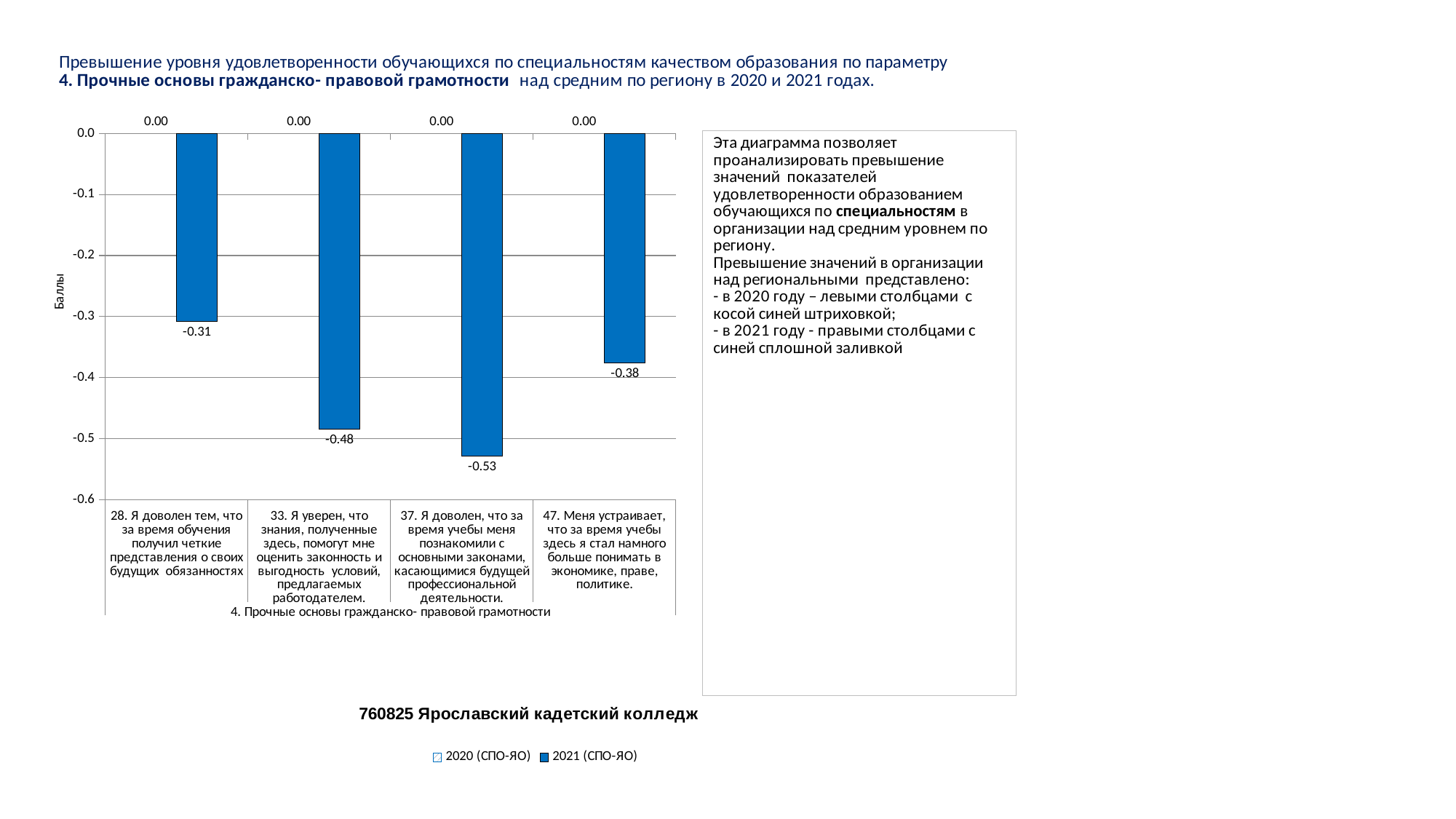
What type of chart is shown on the slide? Bar chart What is the difference between the 2021 (СПО-ЯО) values for category 33 and category 28? 0.17 How many series does the chart legend list? 2 Which category has the highest 2021 (СПО-ЯО) value? 28. Я доволен тем, что за время обучения получил четкие представления о своих будущих обязанностях What is the 2021 (СПО-ЯО) value for category 47 (Меня устраивает, что за время учебы здесь я стал намного больше понимать в экономике, праве, политике)? -0.38 What is the 2020 (СПО-ЯО) value for category 33 (Я уверен, что знания, полученные здесь, помогут мне оценить законность и выгодность условий)? 0.00 What is the 2021 (СПО-ЯО) value for category 37 (Я доволен, что за время учебы меня познакомили с основными законами)? -0.53 Which category has the lowest 2021 (СПО-ЯО) value? 37. Я доволен, что за время учебы меня познакомили с основными законами, касающимися будущей профессиональной деятельности. How many categories are shown on the x axis of the chart? 4 What is the label of the vertical axis of the chart? Баллы What is the 2021 (СПО-ЯО) value for category 28 (Я доволен тем, что за время обучения получил четкие представления о своих будущих обязанностях)? -0.31 Which is larger, the 2021 (СПО-ЯО) value for category 47 or for category 33? Category 47 (-0.38)